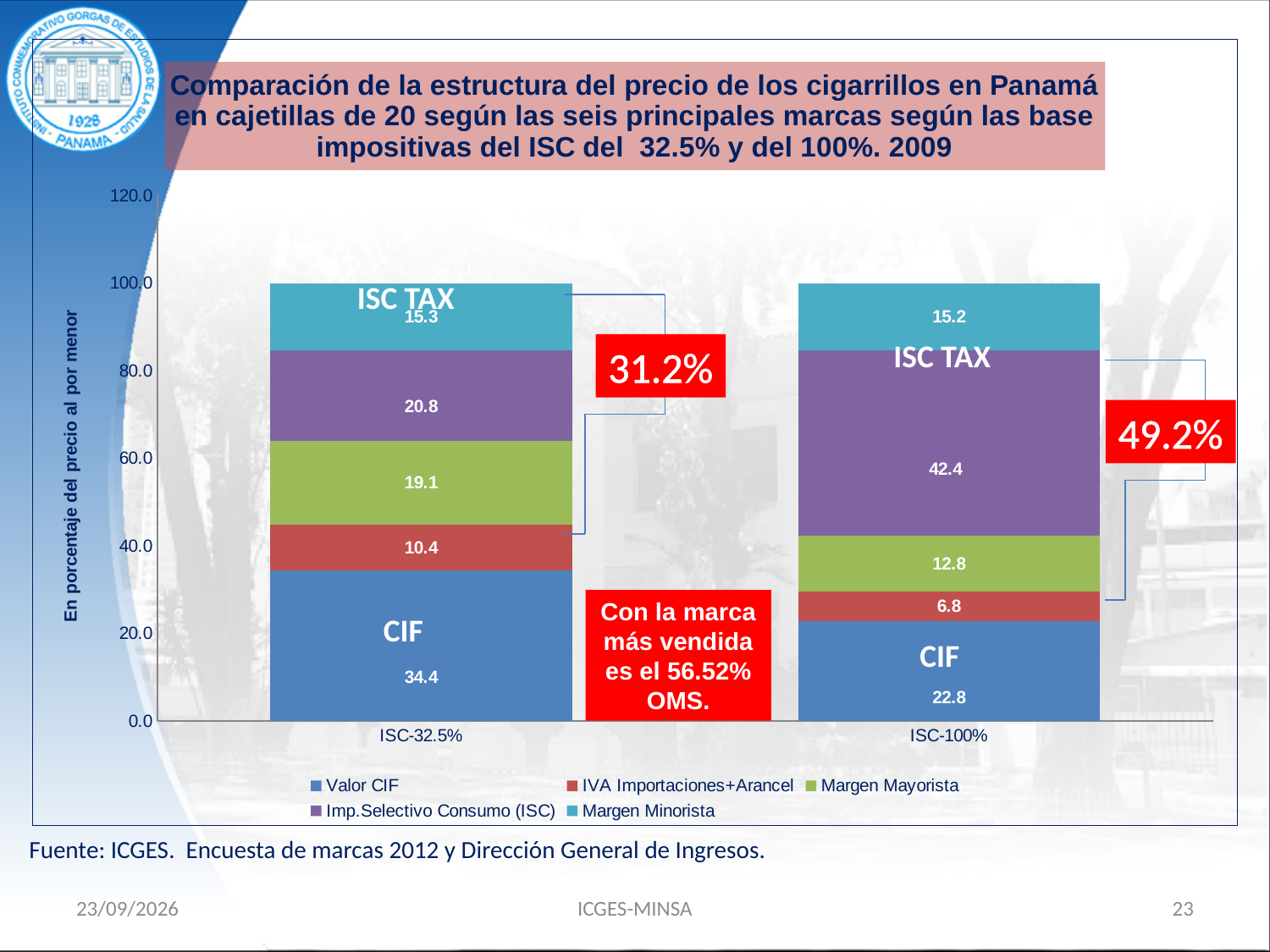
What is the value of Valor CIF for ISC-32.5%? 34.4 What is the value of Imp.Selectivo Consumo (ISC) for ISC-100%? 42.4 Which series has the largest value in the ISC-100% bar? Imp.Selectivo Consumo (ISC) Is the Valor CIF value larger for ISC-32.5% or for ISC-100%? ISC-32.5% What is the value of Margen Mayorista for ISC-100%? 12.8 How many categories are shown on the x axis? 2 What is the value of IVA Importaciones+Arancel for ISC-32.5%? 10.4 What is the value of Margen Minorista for ISC-100%? 15.2 Which series has the smallest value in the ISC-100% bar? IVA Importaciones+Arancel What is the difference between the Imp.Selectivo Consumo (ISC) values for ISC-100% and ISC-32.5%? 21.6 What kind of chart is shown on the slide? Stacked bar chart How many series does the legend list? 5